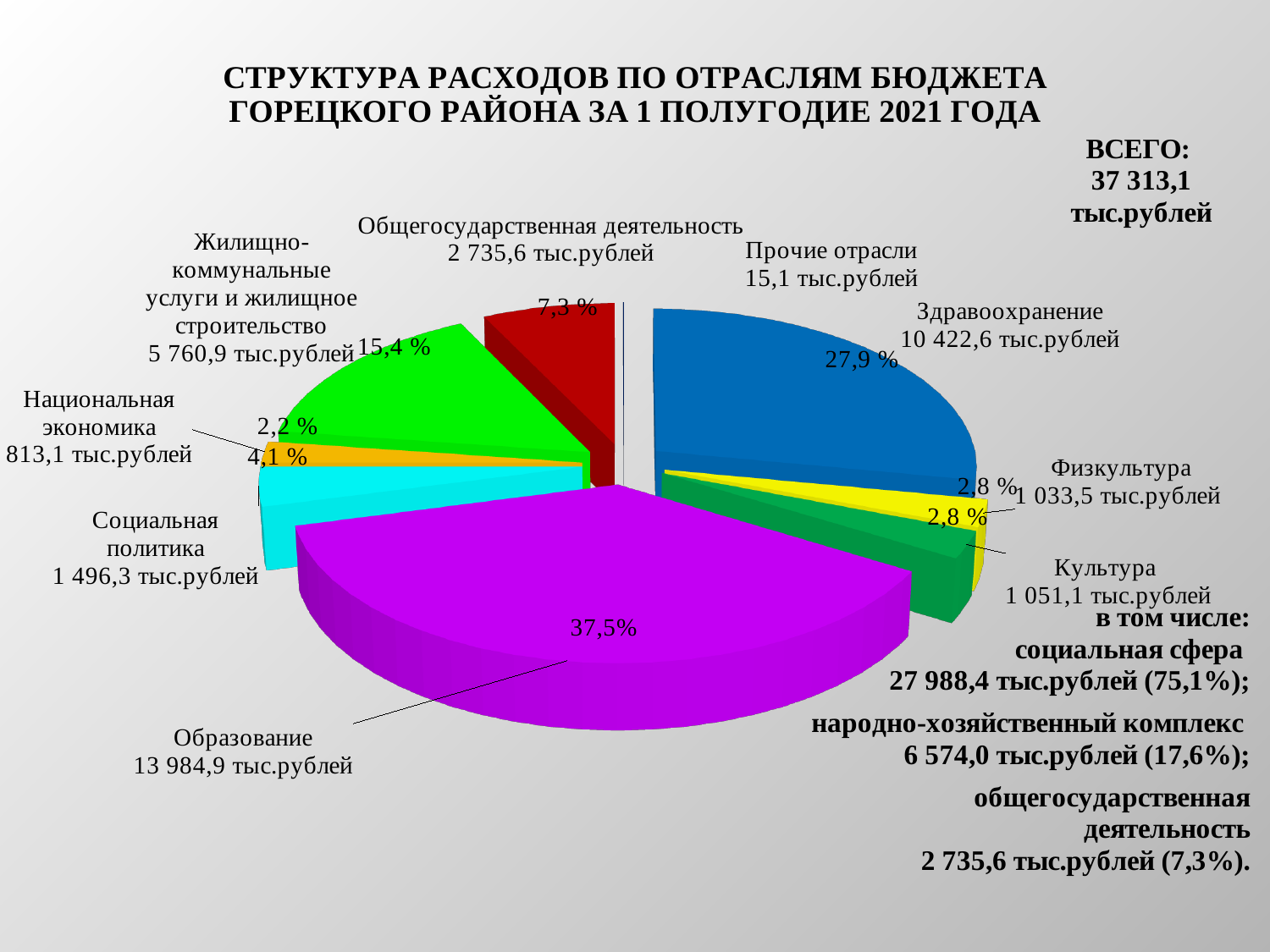
Which category has the smallest slice? Прочие отрасли What is the value for Здравоохранение? 10 422,6 тыс.рублей Which is larger, Здравоохранение or Жилищно-коммунальные услуги и жилищное строительство? Здравоохранение What kind of chart is shown on the slide? Pie chart What is the total of all expenditures shown (ВСЕГО)? 37 313,1 тыс.рублей Which category has the largest slice? Образование What share of the pie does Образование represent? 37,5% What is the value for Образование? 13 984,9 тыс.рублей What share of the pie does Жилищно-коммунальные услуги и жилищное строительство represent? 15,4 % What is the difference between the values for Образование and Здравоохранение? 3 562,3 тыс.рублей How many categories (slices) does the pie chart show? 9 What is the value for Национальная экономика? 813,1 тыс.рублей